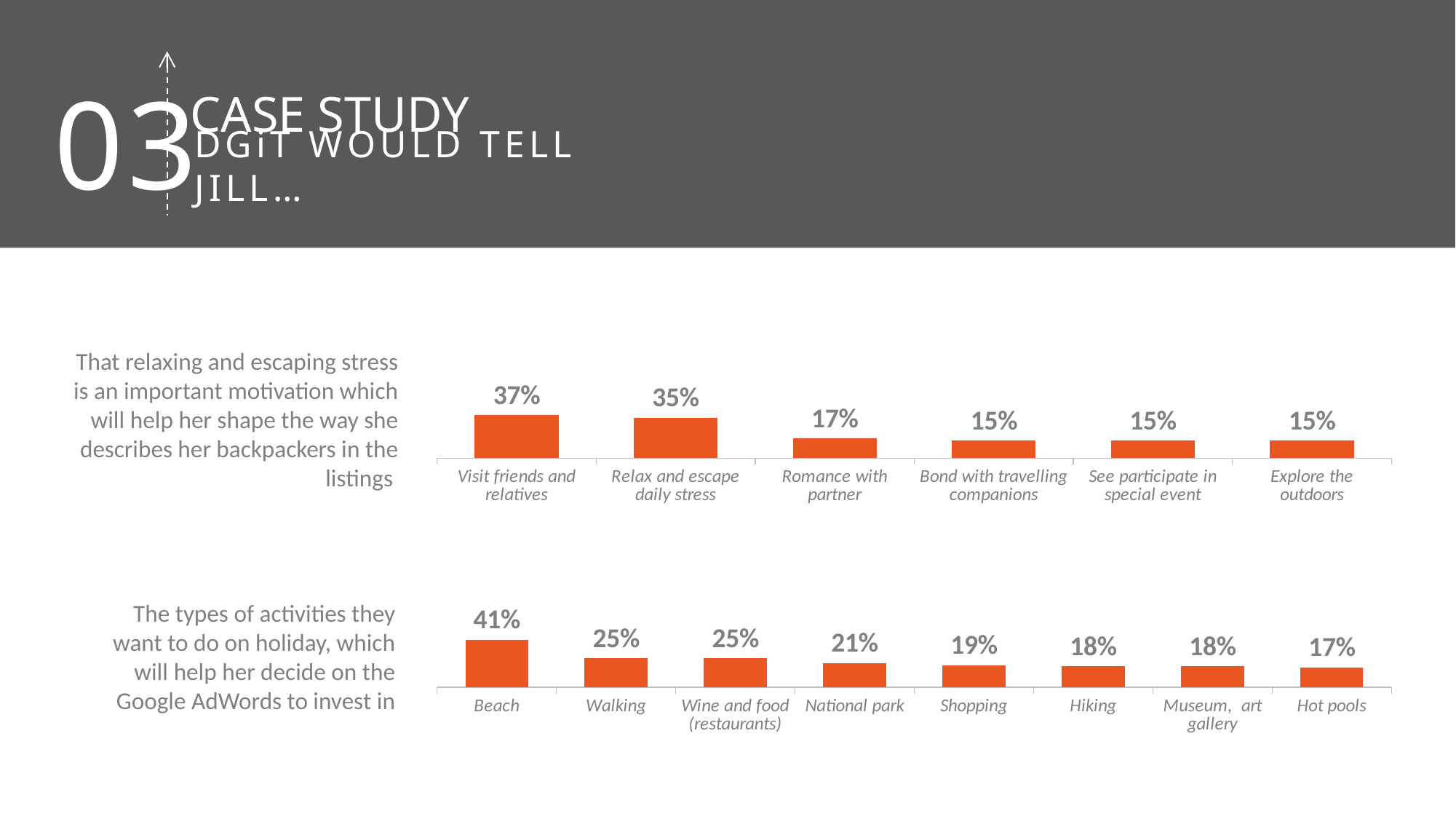
In the top chart, how many categories are shown? 6 In the bottom chart, do the values rise or fall from left to right? Fall In the top chart, which category has the highest value? Visit friends and relatives In the bottom chart, what is the value for National park? 21% In the bottom chart, what is the difference between Beach and Shopping? 22% In the bottom chart, which category has the lowest value? Hot pools In the top chart, what is the value for Relax and escape daily stress? 35% In the bottom chart, how many categories are shown? 8 In the top chart, what is the value for Explore the outdoors? 15% In the top chart, what is the difference between Visit friends and relatives and Romance with partner? 20% What kind of chart is the bottom chart? Bar chart In the bottom chart, which is larger, Beach or Walking? Beach